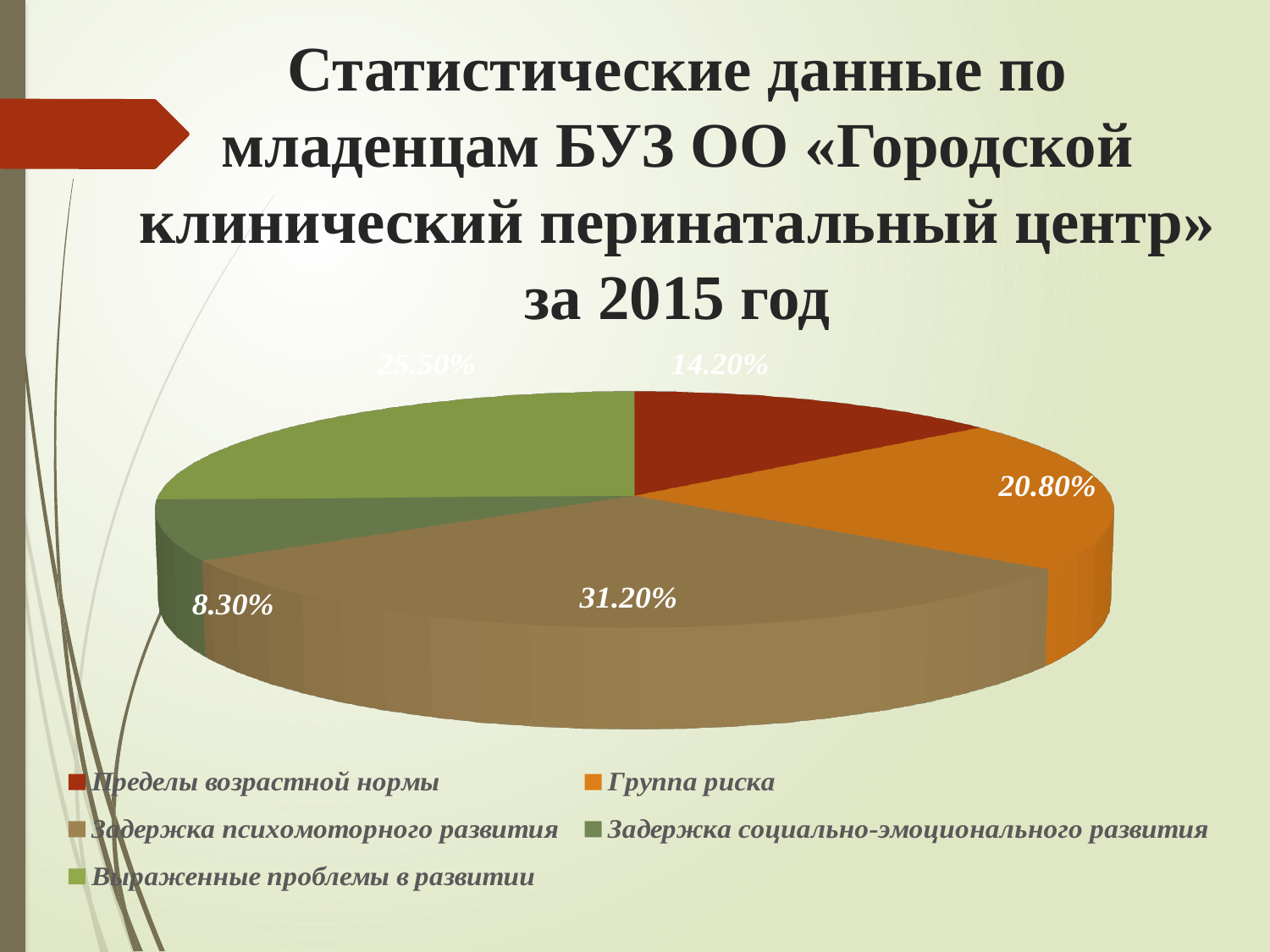
What is the value for Выраженные проблемы в развитии? 25.50% Which category has the smallest share of the pie? Задержка социально-эмоционального развития What is the difference between Задержка психомоторного развития and Выраженные проблемы в развитии? 5.70% What is the value for Пределы возрастной нормы? 14.20% What is the value for Задержка психомоторного развития? 31.20% Which is larger: Группа риска or Пределы возрастной нормы? Группа риска Which colour represents Группа риска in the pie chart? Orange What is the value for Группа риска? 20.80% What is the value for Задержка социально-эмоционального развития? 8.30% Which category has the largest share of the pie? Задержка психомоторного развития How many categories does the pie chart's legend list? 5 What kind of chart is shown on the slide? Pie chart